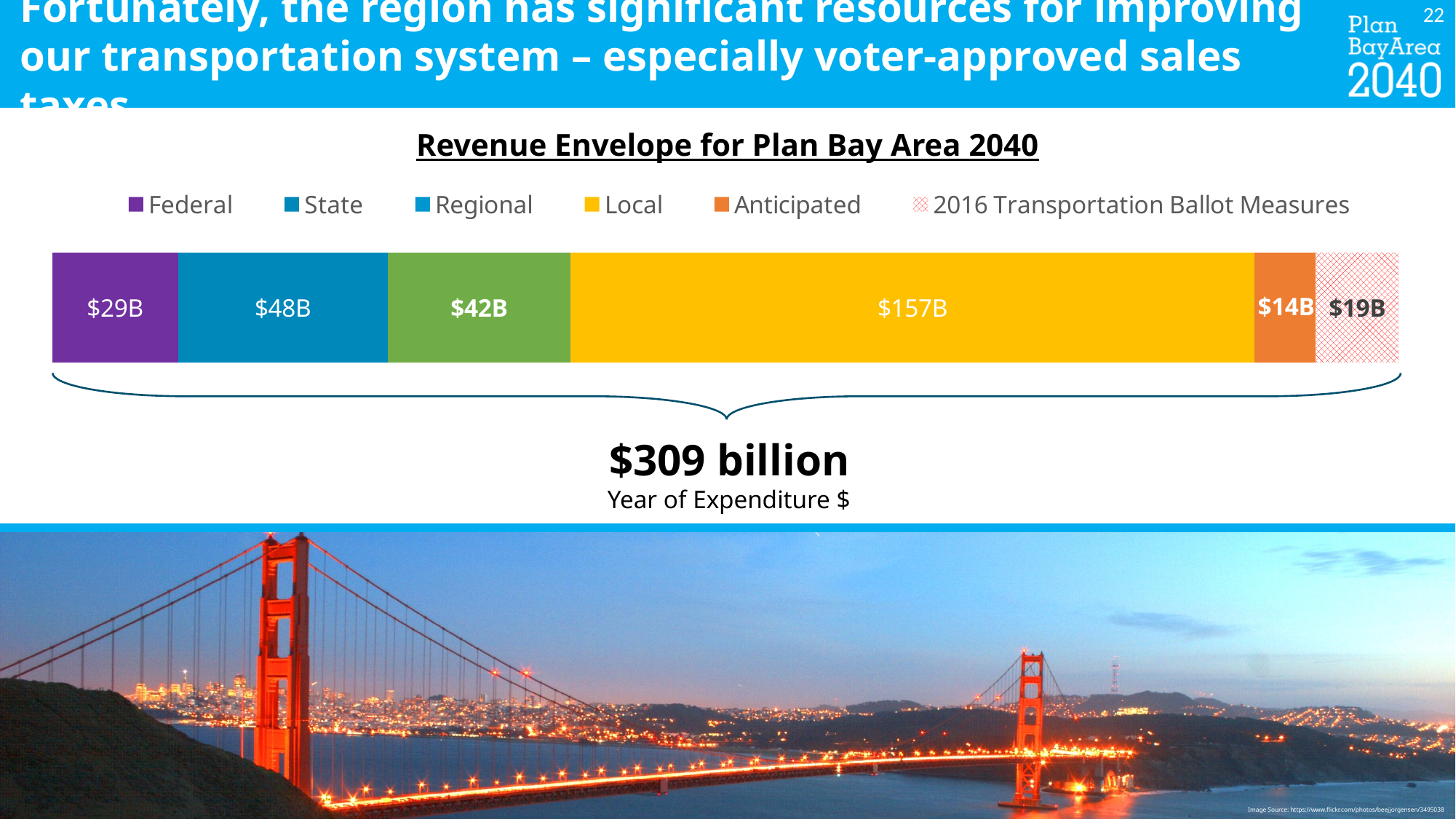
What is the difference between the State and Federal segments? $19B What is the total of the stacked bar? $309 billion What is the title of the chart? Revenue Envelope for Plan Bay Area 2040 What is the value of the State segment in the Revenue Envelope chart? $48B What is the value of the Local segment in the Revenue Envelope chart? $157B What is the value of the Anticipated segment in the Revenue Envelope chart? $14B Which is larger, the State segment or the Regional segment? State What is the value of the Federal segment in the Revenue Envelope chart? $29B Which revenue source has the largest segment in the bar? Local How many series does the legend list? 6 What is the value of the 2016 Transportation Ballot Measures segment? $19B Which revenue source has the smallest segment in the bar? Anticipated